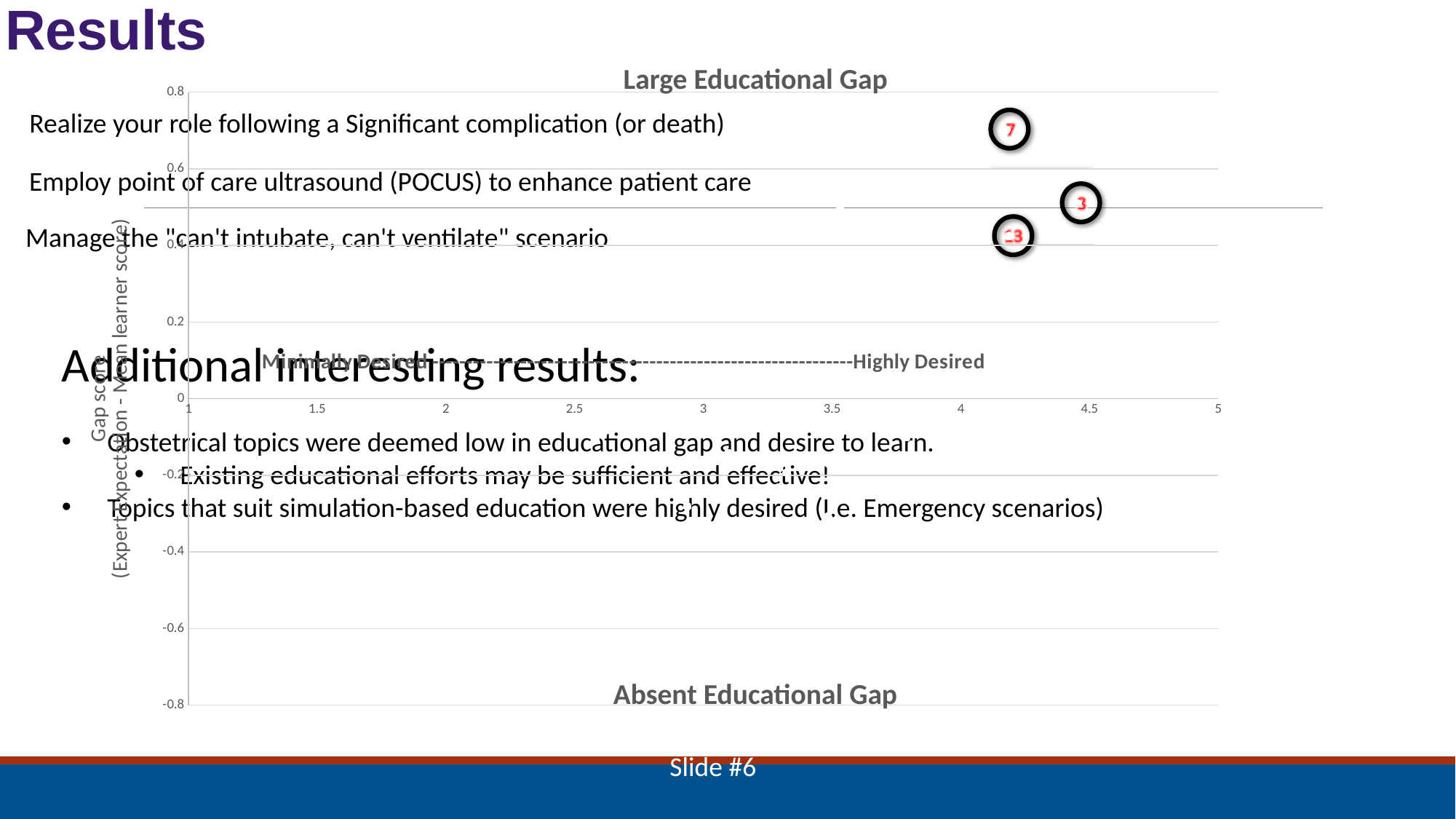
What kind of chart is shown on the slide? scatter chart What label appears at the top of the chart above the plotted points? Large Educational Gap Is the gap score for circled point 7 greater or less than 0.6? greater Is the gap score for circled point 3 greater or less than 0.4? greater Is the x-axis value for circled point 3 greater or less than 4? greater How many circled data points are highlighted on the chart? 3 Which circled point has a higher gap score, 7 or 23? 7 What label appears at the bottom of the chart? Absent Educational Gap Which circled point has the lowest gap score on the chart? 23 Which circled point has the highest gap score on the chart? 7